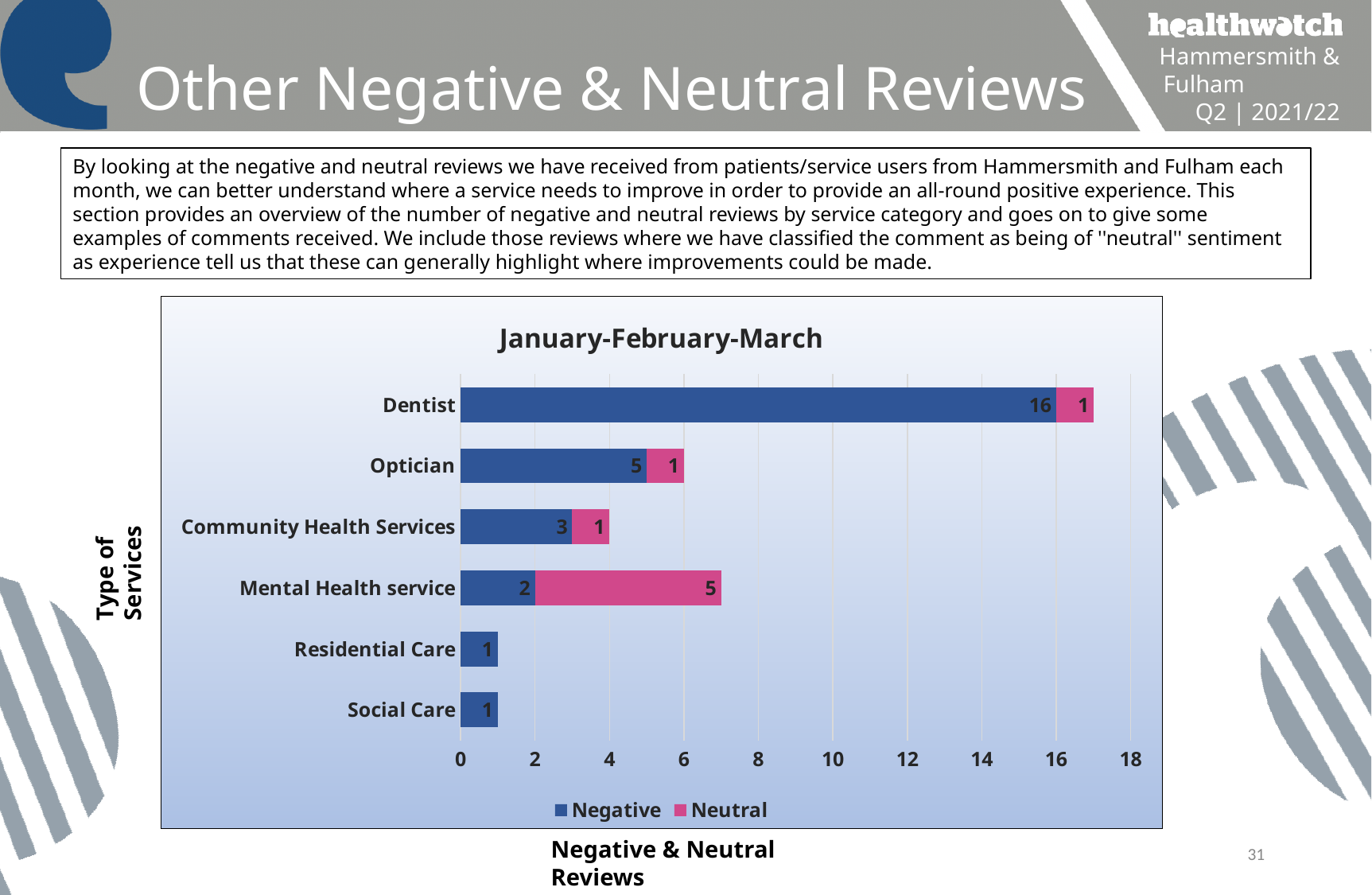
What is the difference between the Negative values for Dentist and Optician? 11 What is the total of the stacked bar for Mental Health service? 7 What type of chart is shown on the slide? Stacked bar chart How many service categories are shown on the chart? 6 Which category has the highest Neutral value? Mental Health service What is the Negative value for Dentist? 16 How many series does the legend list? 2 Which category has the highest Negative value? Dentist What is the Negative value for Optician? 5 What is the Neutral value for Mental Health service? 5 What is the total of the stacked bar for Dentist? 17 Which is larger for Mental Health service, the Negative value or the Neutral value? Neutral